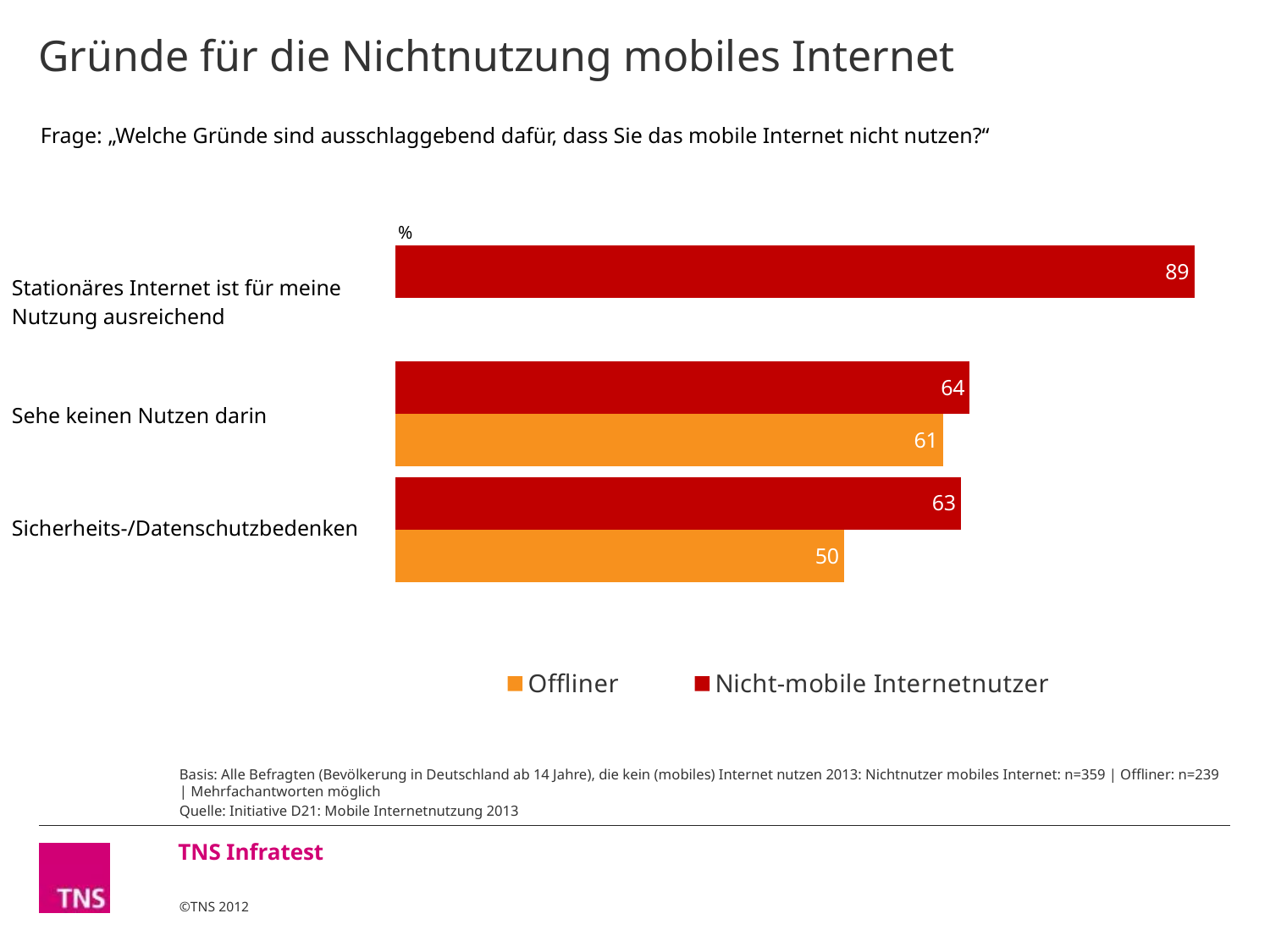
What kind of chart is shown on the slide? Bar chart Which category has the highest value for Nicht-mobile Internetnutzer? Stationäres Internet ist für meine Nutzung ausreichend Which category has the lowest value for Offliner? Sicherheits-/Datenschutzbedenken What is the value for Offliner for "Sehe keinen Nutzen darin"? 61 What is the value for Nicht-mobile Internetnutzer for "Sicherheits-/Datenschutzbedenken"? 63 What is the difference between the Nicht-mobile Internetnutzer and Offliner values for "Sicherheits-/Datenschutzbedenken"? 13 What is the value for Offliner for "Sicherheits-/Datenschutzbedenken"? 50 What is the value for Nicht-mobile Internetnutzer for "Stationäres Internet ist für meine Nutzung ausreichend"? 89 How many series does the legend list? 2 For "Sicherheits-/Datenschutzbedenken", which series has the larger value, Offliner or Nicht-mobile Internetnutzer? Nicht-mobile Internetnutzer What is the difference between the Nicht-mobile Internetnutzer and Offliner values for "Sehe keinen Nutzen darin"? 3 How many categories are shown on the chart? 3